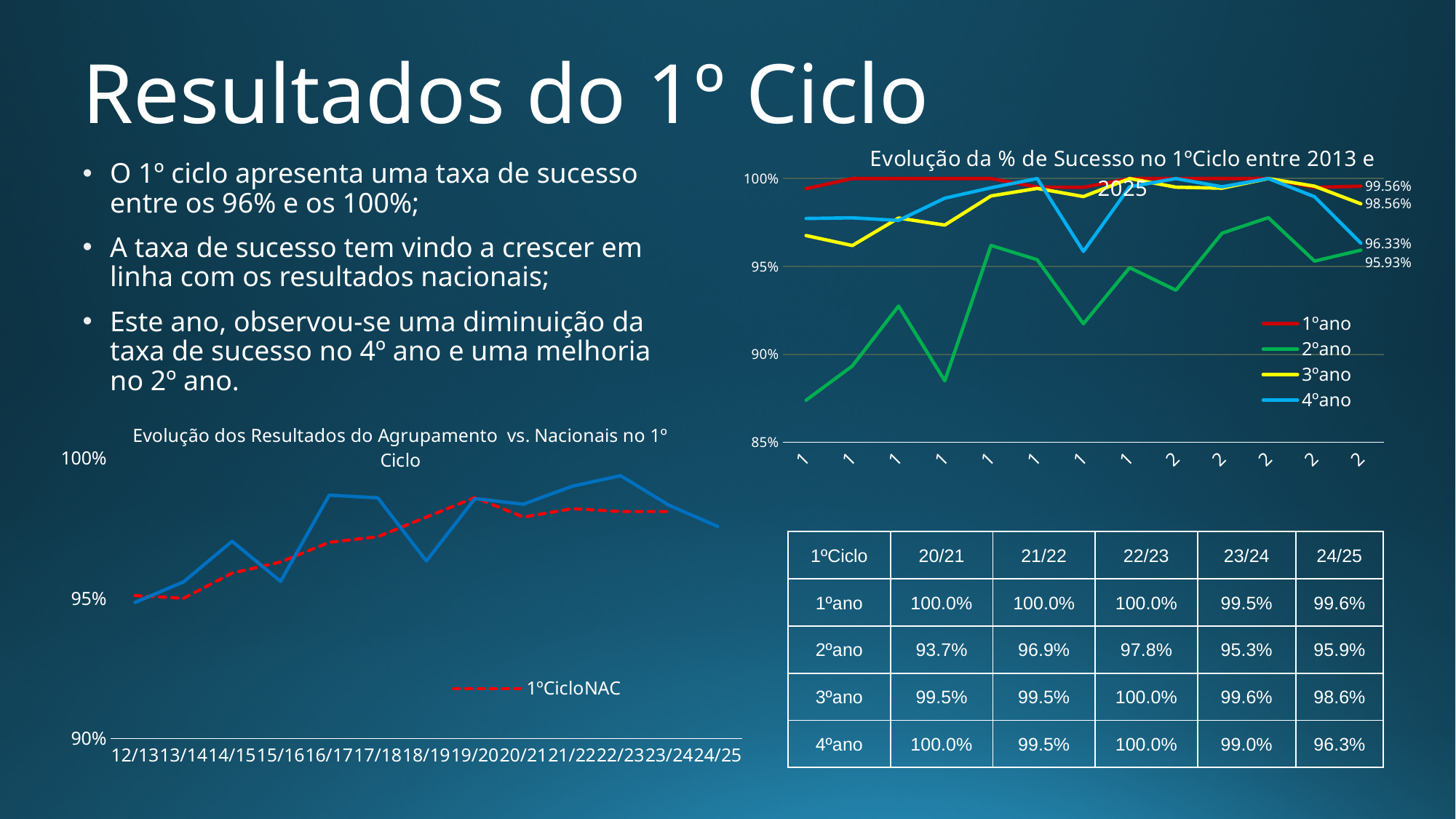
What kind of chart is the chart titled "Evolução dos Resultados do Agrupamento vs. Nacionais no 1º Ciclo"? line chart In the chart "Evolução da % de Sucesso no 1ºCiclo entre 2013 e 2025", is the first value of the 2ºano series greater or less than 90%? less What kind of chart is the chart titled "Evolução da % de Sucesso no 1ºCiclo entre 2013 e 2025"? line chart In the chart "Evolução da % de Sucesso no 1ºCiclo entre 2013 e 2025", what is the labelled final value of the 2ºano series? 95.93% How many series does the legend of the chart "Evolução da % de Sucesso no 1ºCiclo entre 2013 e 2025" list? 4 In the chart "Evolução da % de Sucesso no 1ºCiclo entre 2013 e 2025", which series has the lowest final labelled value? 2ºano In the chart "Evolução da % de Sucesso no 1ºCiclo entre 2013 e 2025", what is the labelled final value of the 3ºano series? 98.56% In the chart "Evolução da % de Sucesso no 1ºCiclo entre 2013 e 2025", what is the labelled final value of the 4ºano series? 96.33% In the chart "Evolução da % de Sucesso no 1ºCiclo entre 2013 e 2025", what is the difference between the final labelled values of 1ºano and 2ºano? 3.63 percentage points How many school-year categories are shown on the x axis of the chart "Evolução dos Resultados do Agrupamento vs. Nacionais no 1º Ciclo"? 13 In the chart "Evolução dos Resultados do Agrupamento vs. Nacionais no 1º Ciclo", what series name is shown in the legend for the red dashed line? 1ºCicloNAC In the chart "Evolução da % de Sucesso no 1ºCiclo entre 2013 e 2025", what is the labelled final value of the 1ºano series? 99.56%